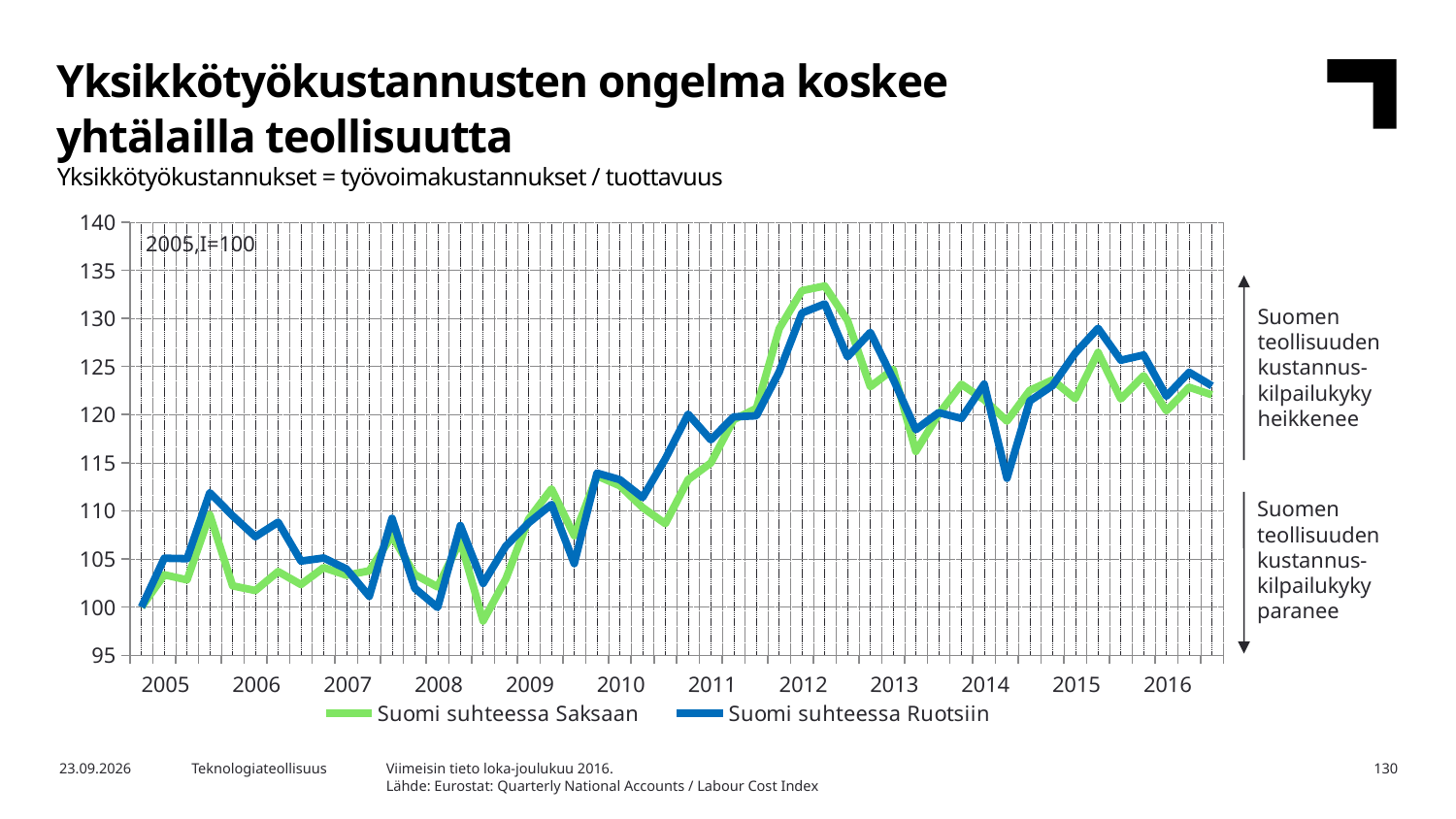
Is the lowest value of the 'Suomi suhteessa Ruotsiin' series in 2014 greater or less than 115? less What is the value of both series at the start of the chart in the first quarter of 2005? 100 Is the peak value of the 'Suomi suhteessa Saksaan' series in 2012 greater or less than 130? greater What index base is printed inside the chart area? 2005,I=100 How many series does the chart legend list? 2 Do the two series rise or fall from their 2012 peak to 2013? fall What are the two series named in the chart legend? Suomi suhteessa Saksaan; Suomi suhteessa Ruotsiin Is the highest value of the 'Suomi suhteessa Ruotsiin' series in 2015 greater or less than 125? greater Do the two series rise or fall between 2010 and their peak in 2012? rise What kind of chart is shown on the slide? line chart How many years are labelled on the x axis? 12